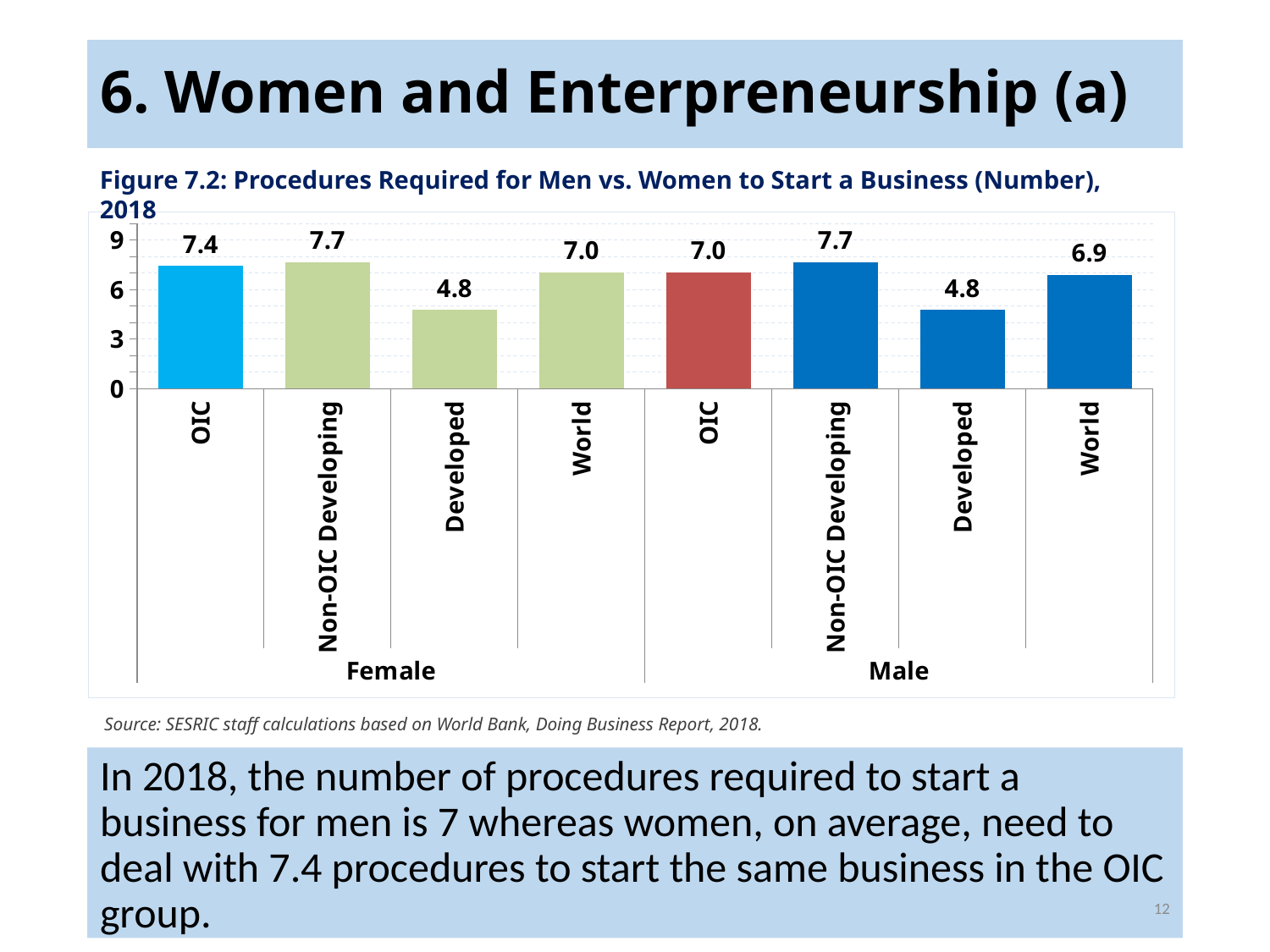
Which category has the highest value in the Female group? Non-OIC Developing What is the difference between the Non-OIC Developing value and the Developed value in the Female group? 2.9 How many bars are plotted in the chart? 8 Which category has the lowest value in the Male group? Developed What is the difference between the OIC value for Female and the OIC value for Male? 0.4 What is the value for Developed in the Female group? 4.8 Which is larger: the World value for Female or the World value for Male? World value for Female What is the value for OIC in the Female group? 7.4 What kind of chart is shown? Bar chart Is the value for Developed in the Male group greater or less than 6? less What is the value for World in the Male group? 6.9 What is the title of the figure? Figure 7.2: Procedures Required for Men vs. Women to Start a Business (Number), 2018